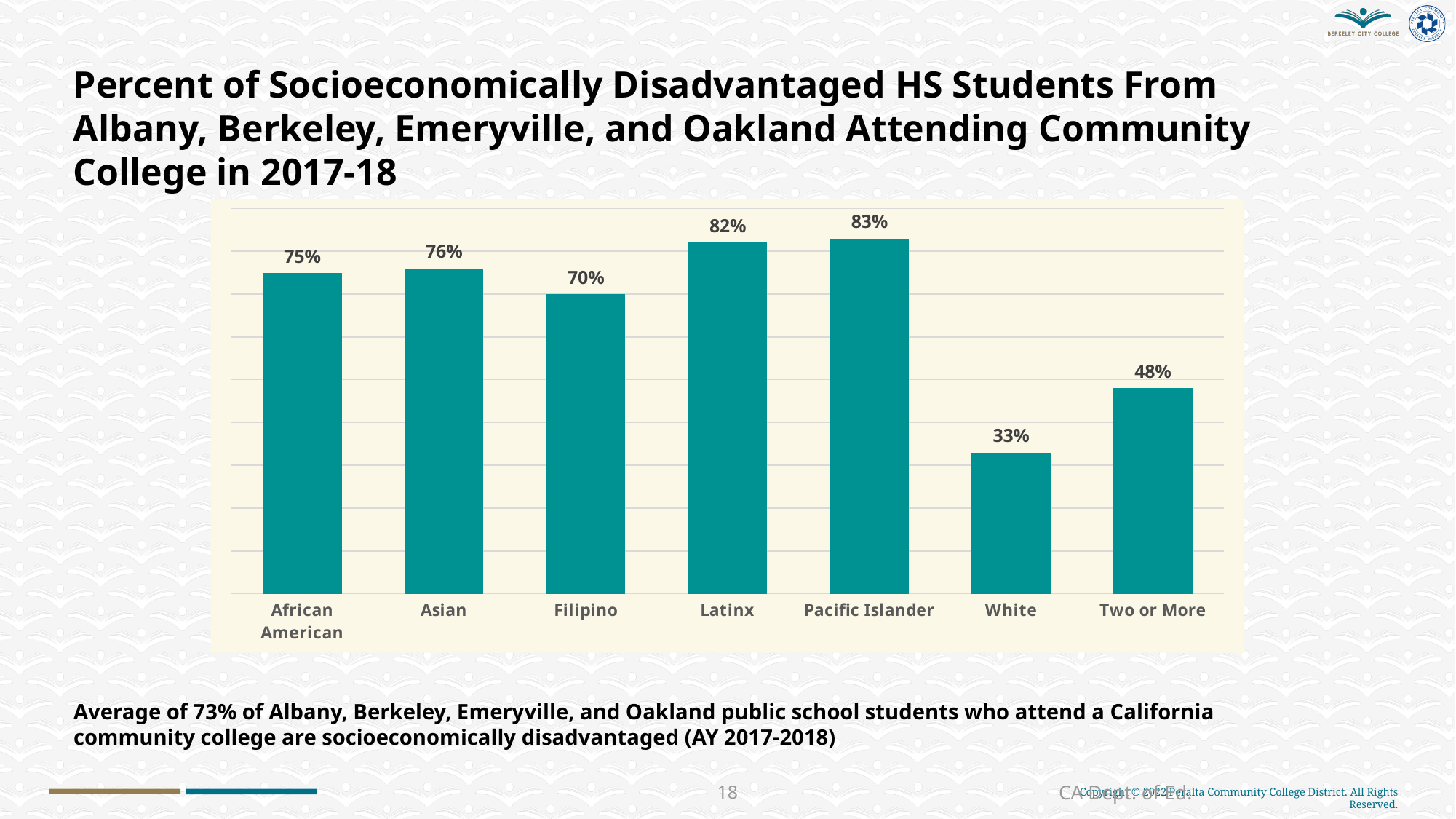
What kind of chart is shown on the slide? Bar chart Which category has the highest value? Pacific Islander How many categories are shown on the chart? 7 What is the difference between the values for Asian and African American? 1% Which is larger, the value for Filipino or the value for Two or More? Filipino Which category has the lowest value? White What is the value for White? 33% What is the value for Latinx? 82% What colour are the bars in the chart? Teal What is the value for Two or More? 48% What is the difference between the values for Pacific Islander and White? 50% What is the value for Filipino? 70%